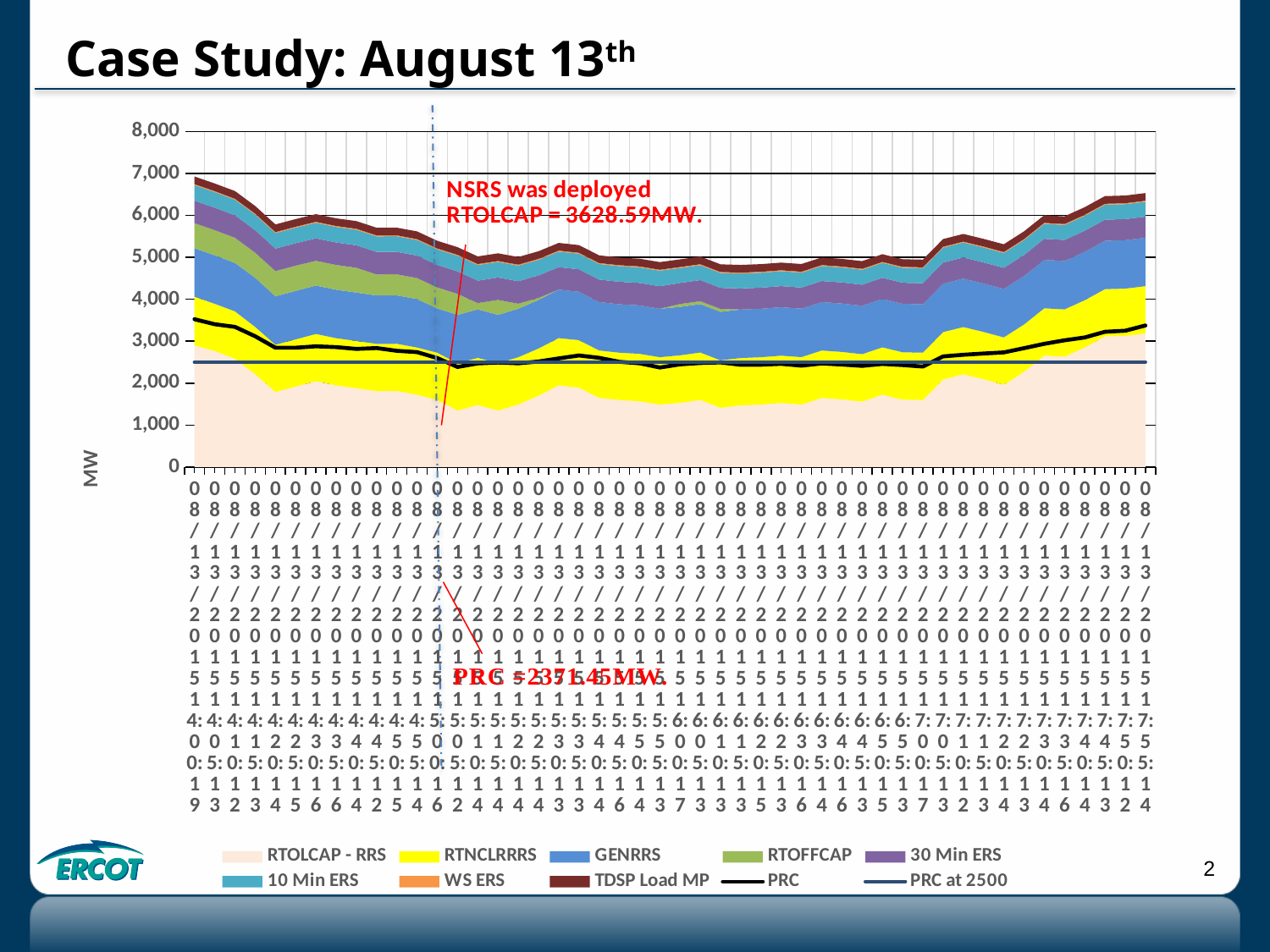
Does the PRC line rise or fall over the first third of the x axis? fall Is the total stacked height at the rightmost point greater or less than 6,000? greater How many series does the legend list? 10 Is the lowest point of the PRC line greater or less than 3,000? less Is the PRC value at the leftmost point of the chart greater or less than 3,000? greater What is the label on the vertical axis? MW What kind of chart is shown on the slide? area chart Which series is plotted at the bottom of the stacked areas? RTOLCAP - RRS What is the highest tick value shown on the vertical axis? 8,000 According to the annotation, what was RTOLCAP when NSRS was deployed? 3628.59MW At what level is the horizontal 'PRC at 2500' reference line drawn? 2500